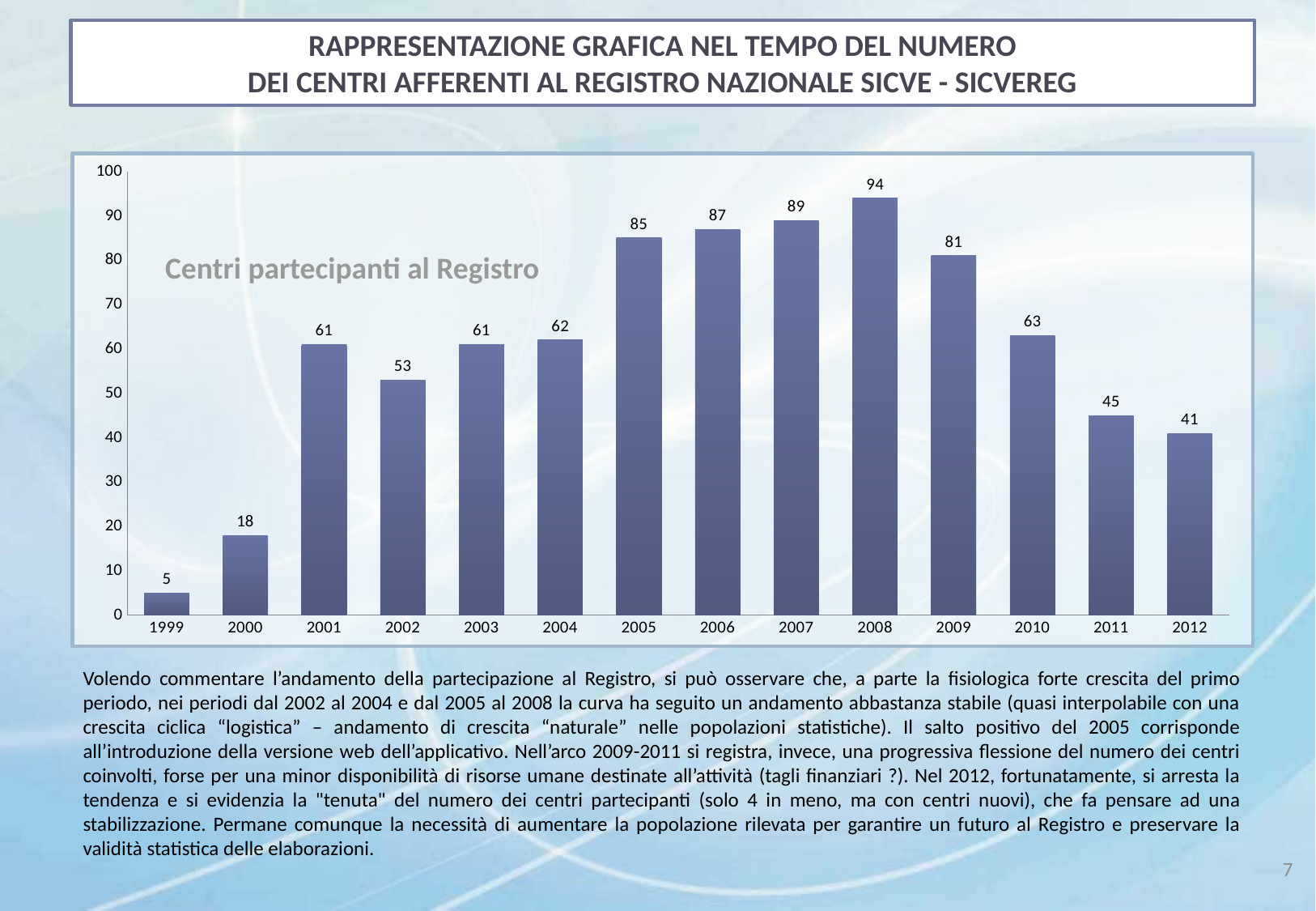
Is the value for 2005 greater or less than 80? greater What is the value for 2012? 41 What is the difference between the values for 2008 and 2012? 53 Which year has the highest value? 2008 What is the value for 2008? 94 How many years are shown on the x axis? 14 What is the difference between the values for 2000 and 1999? 13 What is the title shown inside the chart area? Centri partecipanti al Registro What kind of chart is this? bar chart What is the value for 1999? 5 Which year has the lowest value? 1999 Which is larger, the value for 2009 or the value for 2010? 2009